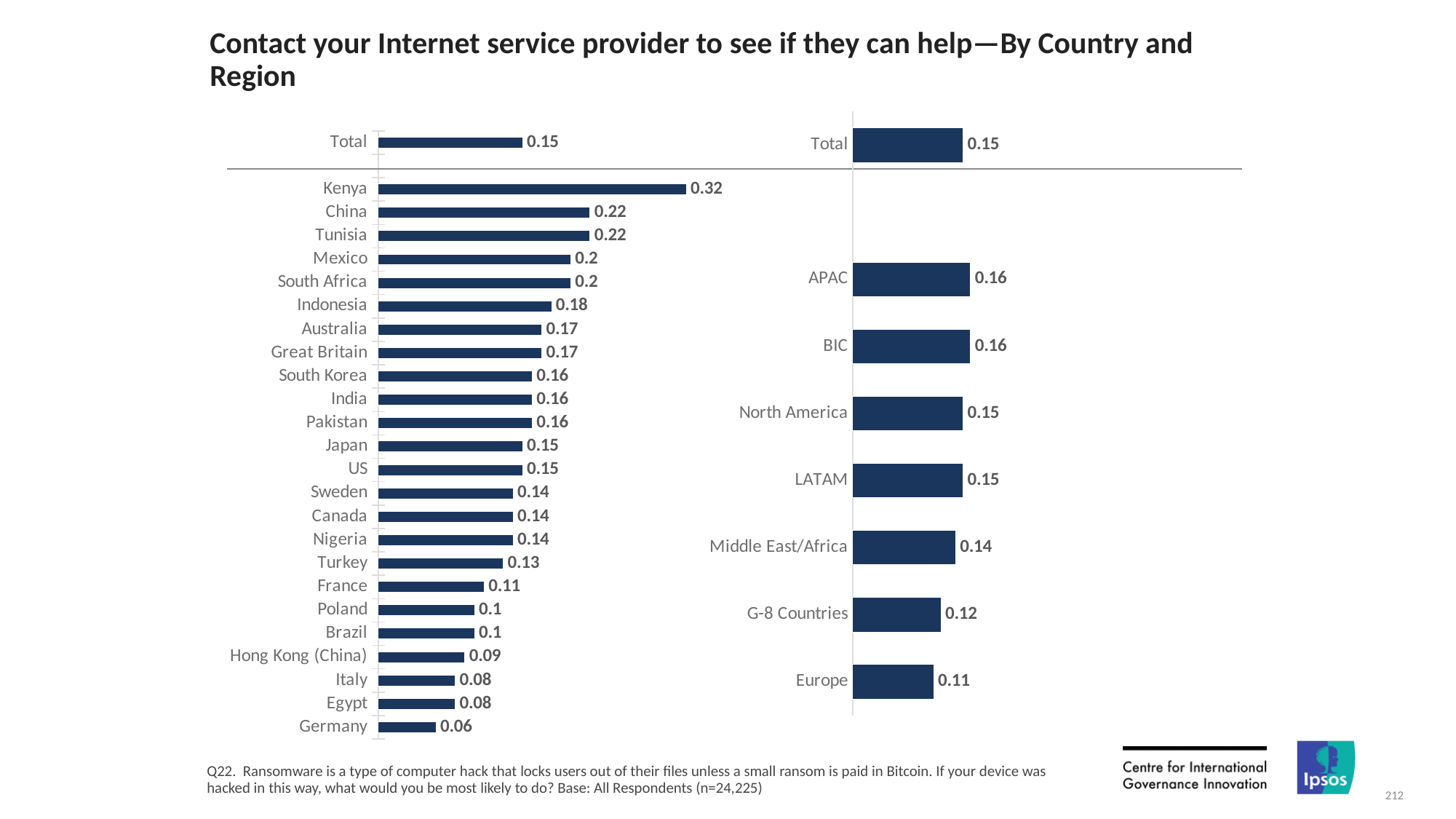
In the left chart (by country), what is the value for Kenya? 0.32 In the left chart (by country), how many countries are listed below the Total bar? 24 In the right chart (by region), what is the difference between the values for APAC and Europe? 0.05 In the left chart (by country), which country has the lowest value? Germany In the left chart (by country), what is the difference between the values for Kenya and China? 0.1 In the right chart (by region), what is the value for Middle East/Africa? 0.14 In the right chart (by region), which region has the lowest value? Europe In the left chart (by country), which is larger, the value for Indonesia or the value for Turkey? Indonesia What type of chart is used on this slide? Bar chart In the left chart (by country), what is the value for Germany? 0.06 In the left chart (by country), which country has the highest value? Kenya In the right chart (by region), how many regions are listed below the Total bar? 7